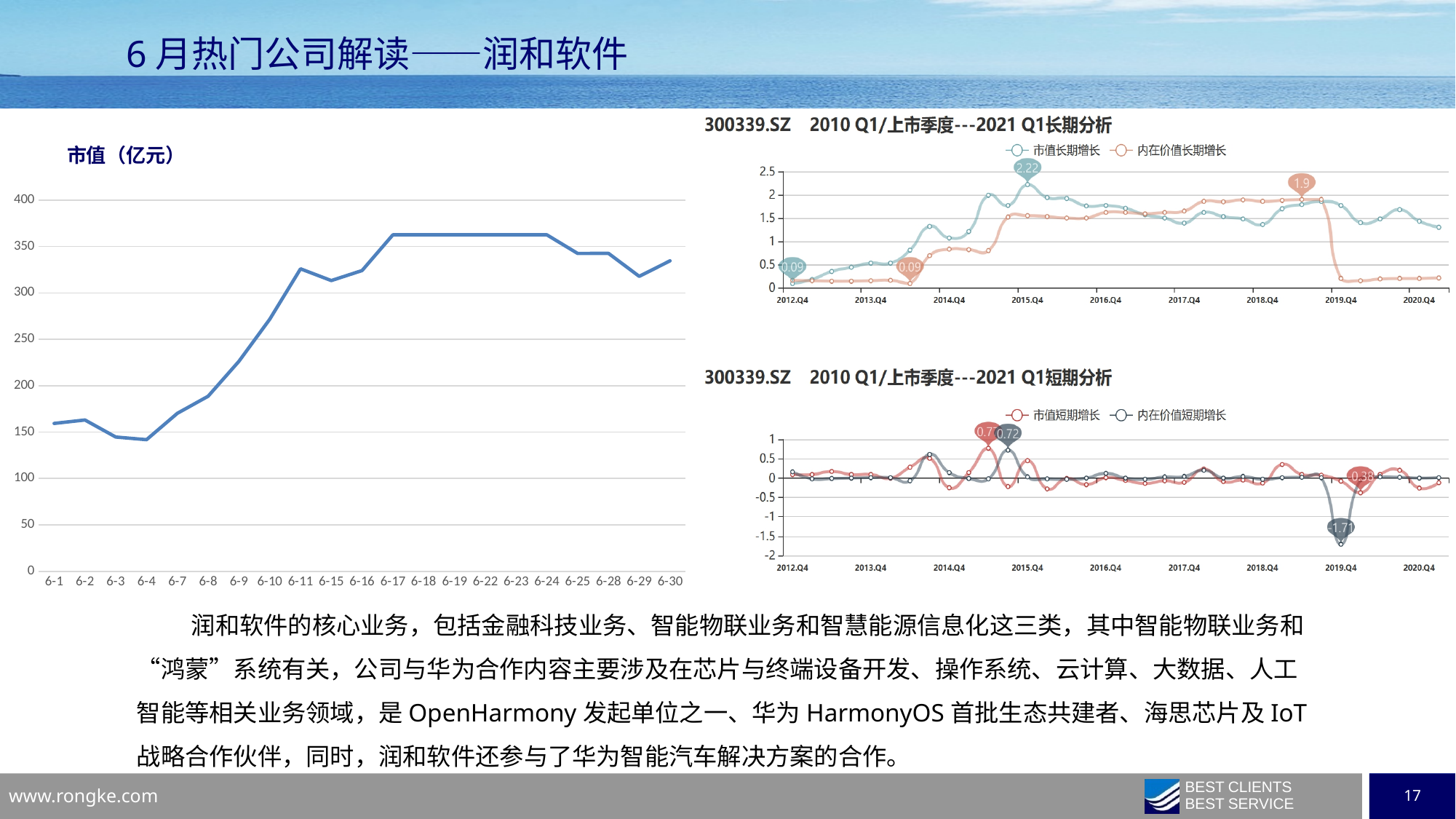
What are the two legend entries of the 短期分析 chart (bottom right)? 市值短期增长 and 内在价值短期增长 In the 市值（亿元） chart, is the value for 6-17 greater or less than 350? greater In the 市值（亿元） chart, is the value for 6-11 greater or less than 300? greater In the 市值（亿元） chart, is the value for 6-4 greater or less than 150? less In the 长期分析 chart (top right), what is the labelled peak value of 市值长期增长? 2.22 In the 市值（亿元） chart, do the values overall rise or fall from 6-1 to 6-30? rise What kind of chart is the 市值（亿元） chart on the left of the slide? line chart How many dates are plotted on the x axis of the 市值（亿元） chart? 21 How many series does the legend of the 长期分析 chart (top right) list? 2 In the 市值（亿元） chart, which is larger, the value for 6-1 or the value for 6-30? 6-30 In the 短期分析 chart (bottom right), what is the labelled lowest value of 内在价值短期增长? -1.71 In the 长期分析 chart (top right), what is the labelled peak value of 内在价值长期增长? 1.9